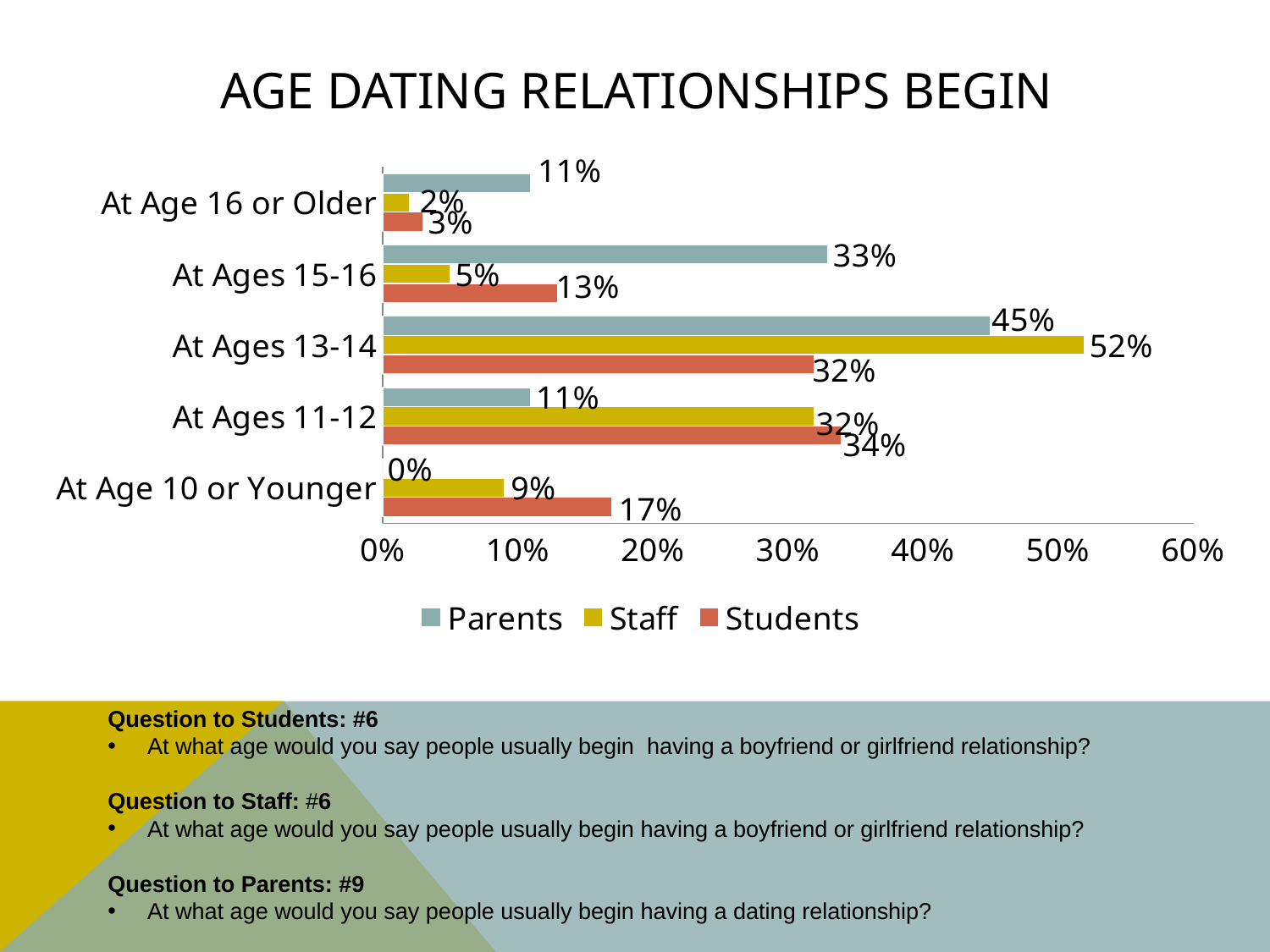
How many series does the legend list? 3 Which age category has the highest value for Parents? At Ages 13-14 What percentage of Parents said dating relationships begin at age 10 or younger? 0% How many age categories are shown on the chart? 5 What percentage of Students said dating relationships begin at ages 15-16? 13% Which series is shown in yellow in the legend? Staff Which age category has the lowest value for Staff? At Age 16 or Older What is the difference between the Parents and Students values for ages 15-16? 20% For ages 11-12, which is larger: the Parents value or the Students value? Students What kind of chart is shown on the slide? Bar chart What is the title of the chart? AGE DATING RELATIONSHIPS BEGIN What percentage of Staff said dating relationships begin at ages 13-14? 52%